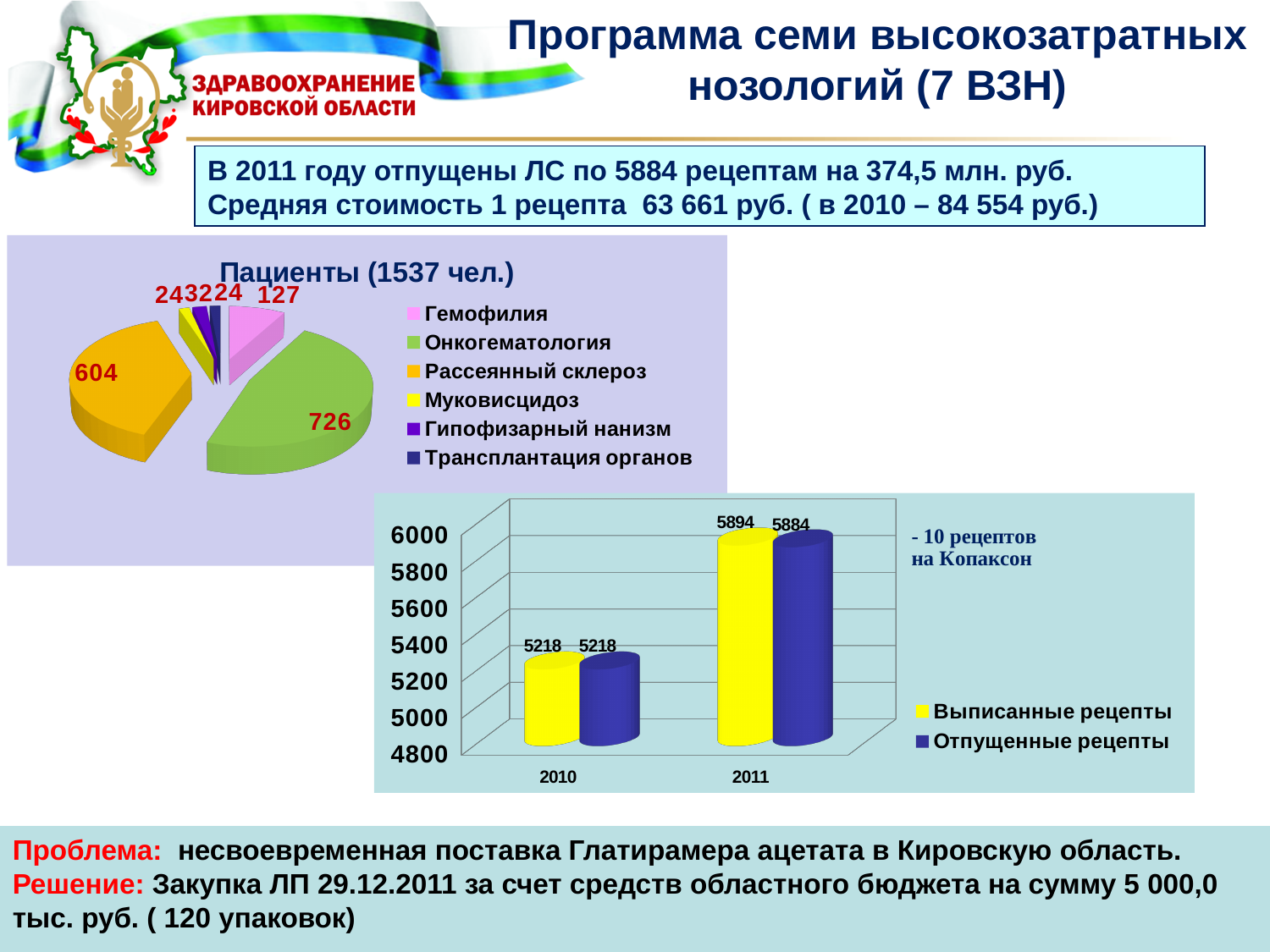
In the bar chart at the bottom right, what is the difference between Выписанные рецепты and Отпущенные рецепты in 2011? 10 In the bar chart at the bottom right, what is the value of Отпущенные рецепты for 2011? 5884 In the bar chart at the bottom right, do the Выписанные рецепты values rise or fall from 2010 to 2011? rise In the pie chart 'Пациенты (1537 чел.)', what is the value for Рассеянный склероз? 604 In the bar chart at the bottom right, what is the value of Выписанные рецепты for 2011? 5894 How many series does the legend of the bar chart at the bottom right list? 2 In the bar chart at the bottom right, what is the value of Выписанные рецепты for 2010? 5218 In the pie chart 'Пациенты (1537 чел.)', what is the difference between the Онкогематология and Рассеянный склероз values? 122 How many categories does the legend of the pie chart 'Пациенты (1537 чел.)' list? 6 In the pie chart 'Пациенты (1537 чел.)', how many patients are in the Онкогематология category? 726 In the pie chart 'Пациенты (1537 чел.)', which category has the largest slice? Онкогематология In the pie chart 'Пациенты (1537 чел.)', what is the value for Гемофилия? 127